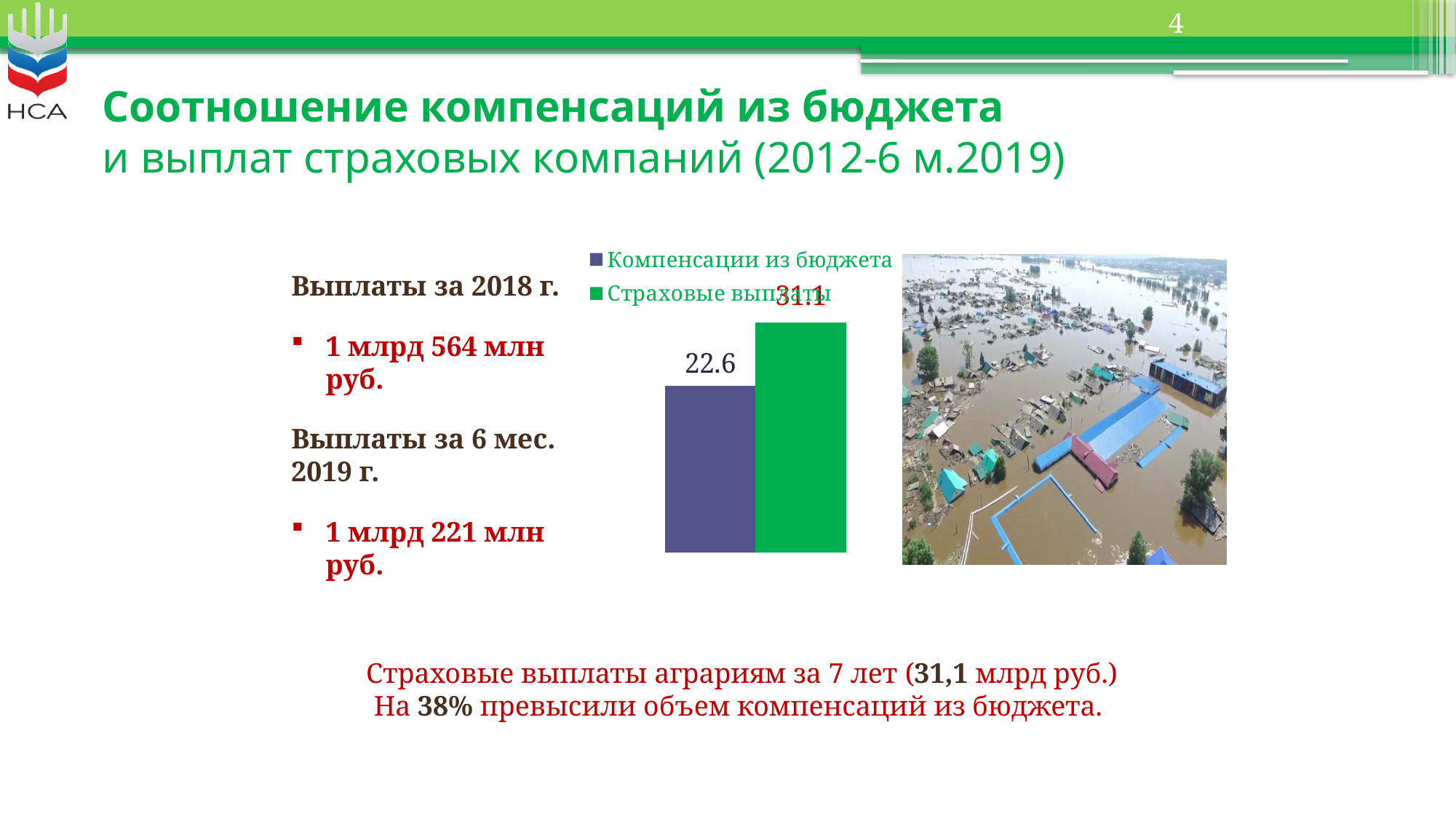
What is the value of the Компенсации из бюджета bar? 22.6 What colour is the Страховые выплаты bar? green What is the difference between the Страховые выплаты bar and the Компенсации из бюджета bar? 8.5 What is the value of the Страховые выплаты bar? 31.1 How many bars are plotted in the chart? 2 What kind of chart is shown on the slide? bar chart Is the Компенсации из бюджета bar larger or smaller than the Страховые выплаты bar? smaller Which series has the higher bar in the chart? Страховые выплаты Which series has the lower bar in the chart? Компенсации из бюджета How many series does the chart legend list? 2 What colour is the Компенсации из бюджета bar? purple